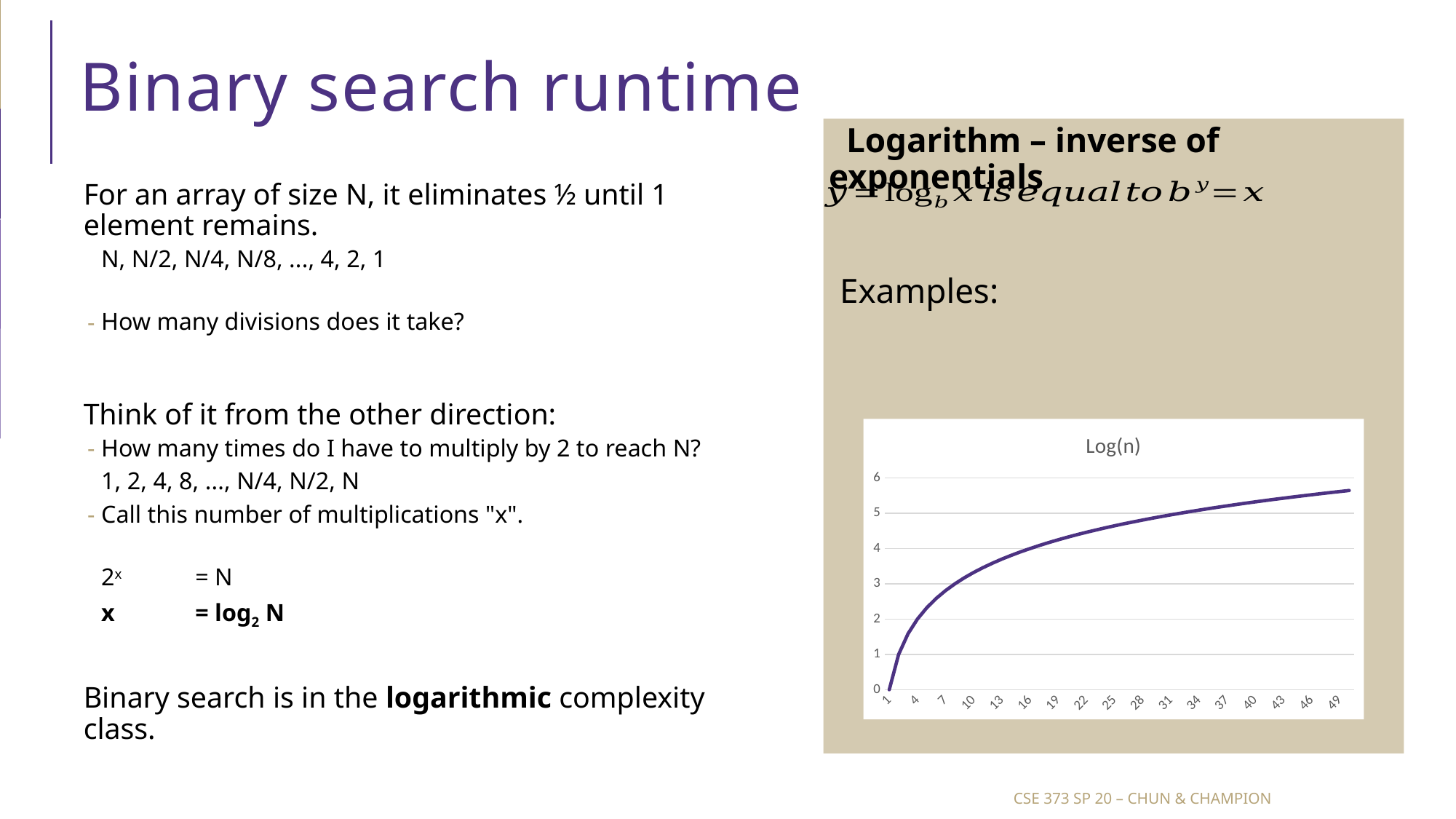
Do the values on the Log(n) chart rise or fall as n increases along the x axis? rise Is the value of the Log(n) curve at n = 4 greater or less than 3? less What kind of chart is shown on the slide? line chart What is the value of the Log(n) curve at n = 1? 0 At which labelled x-axis value does the Log(n) curve reach its highest point? 49 At which labelled x-axis value is the Log(n) curve lowest? 1 Is the value of the Log(n) curve at n = 31 greater or less than 4? greater Is the value of the Log(n) curve at n = 49 greater or less than 5? greater Which is larger on the Log(n) chart: the value at n = 10 or the value at n = 40? n = 40 What is the title of the chart? Log(n)